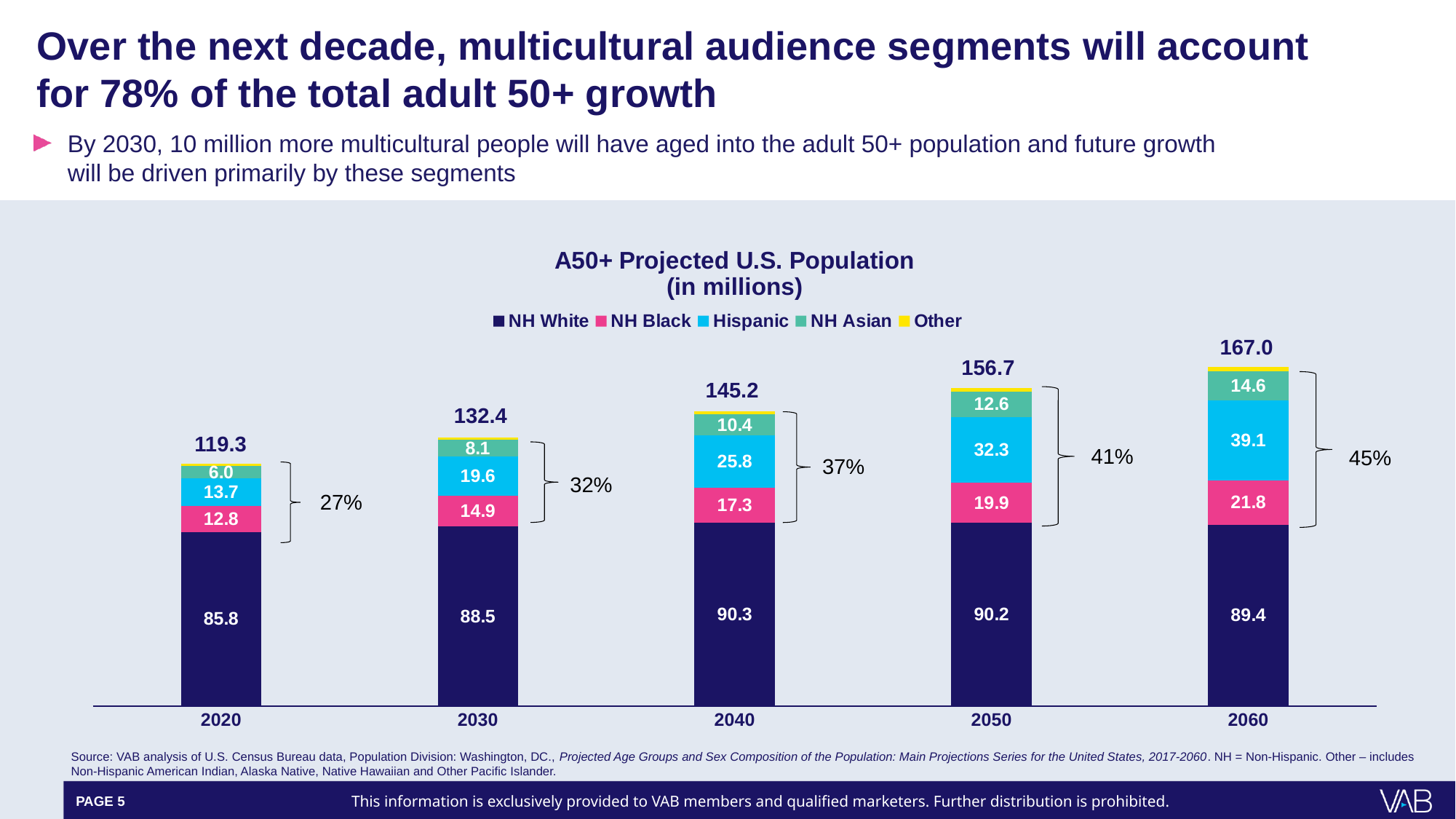
What is the total of the stacked bar for 2050? 156.7 Do the total values rise or fall from 2020 to 2060? Rise What is the NH Asian value for 2020? 6.0 What is the difference between the Hispanic values for 2060 and 2020? 25.4 What kind of chart is shown on the slide? Stacked bar chart Which is larger in 2030, the NH Black value or the Hispanic value? Hispanic What is the Hispanic value for 2060? 39.1 How many series does the legend list? 5 What is the NH White value for 2040? 90.3 Which year has the lowest total A50+ projected population? 2020 How many years are shown on the x axis? 5 Which year has the highest total A50+ projected population? 2060